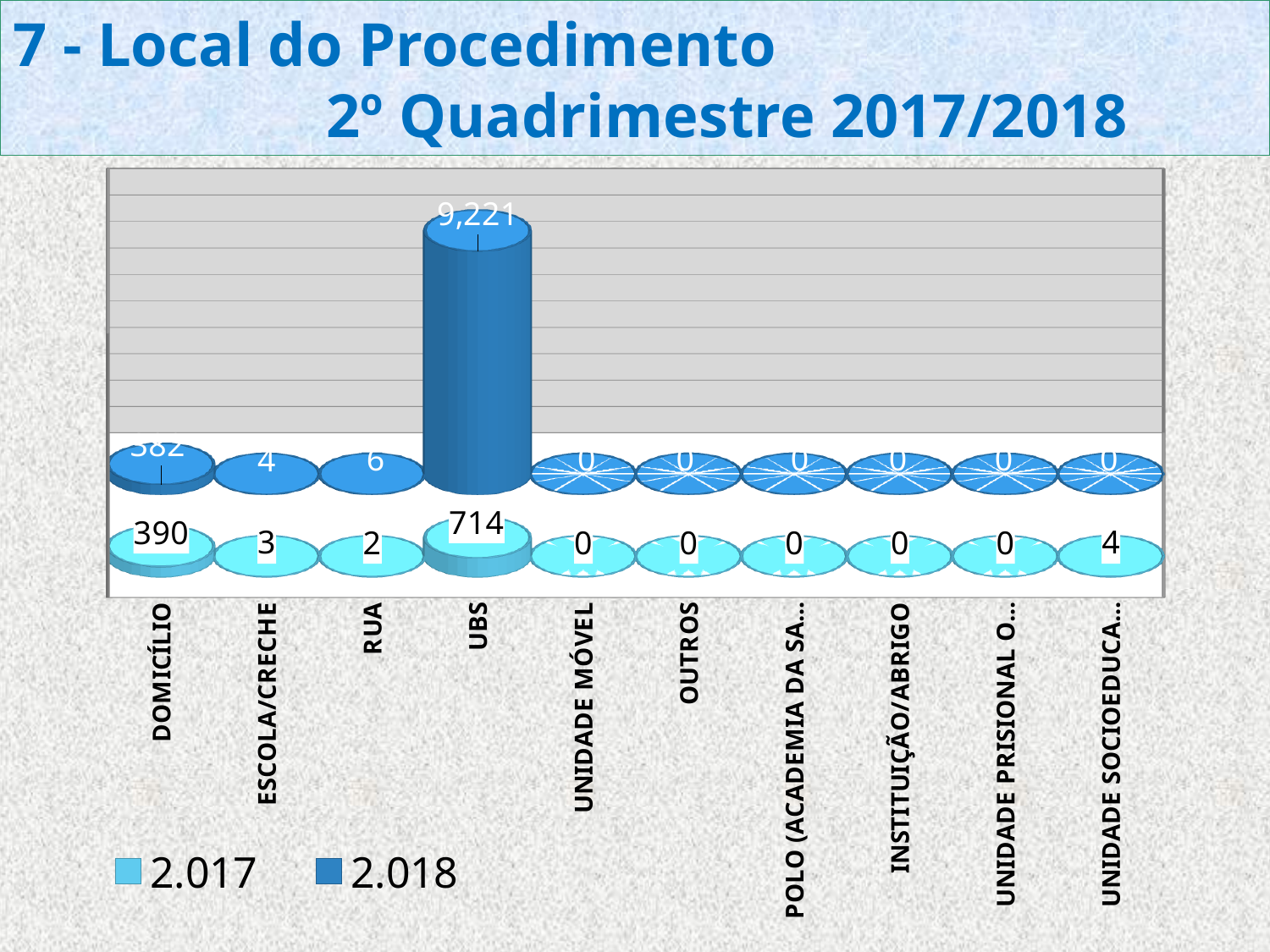
Which category has the highest value in the 2.018 series? UBS What is the difference between the 2.018 and 2.017 values for UBS? 8,507 How many categories are shown on the x axis? 10 What is the value for DOMICÍLIO in the 2.017 series? 390 What is the value for RUA in the 2.018 series? 6 What is the value for UBS in the 2.018 series? 9,221 Which category has the highest value in the 2.017 series? UBS What kind of chart is shown on the slide? Bar chart What is the value for ESCOLA/CRECHE in the 2.017 series? 3 What is the value for UBS in the 2.017 series? 714 For RUA, which series has the larger value, 2.017 or 2.018? 2.018 How many series does the legend list? 2